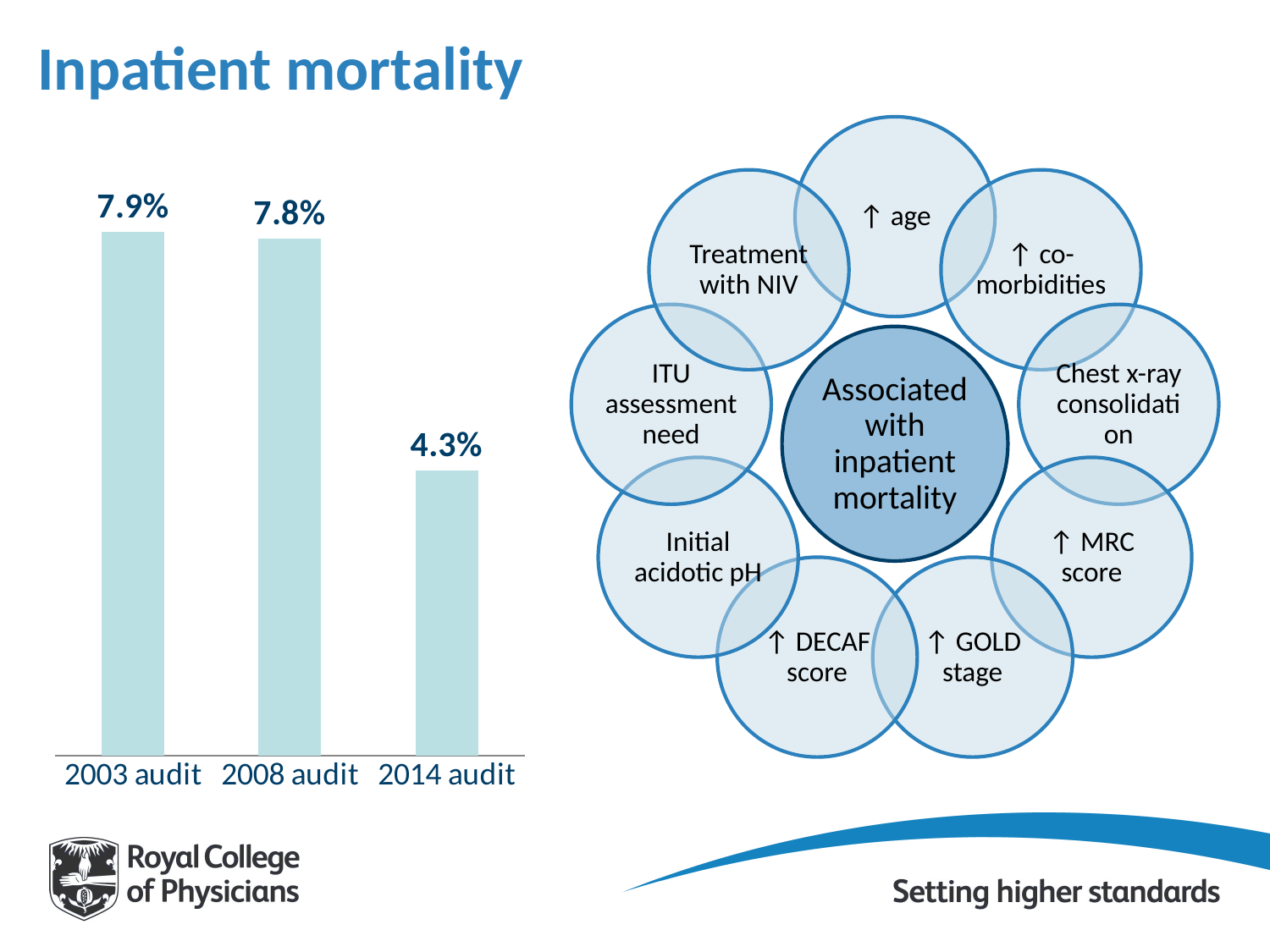
What is the difference in inpatient mortality between the 2008 audit and the 2014 audit? 3.5% Which is larger, the inpatient mortality for the 2008 audit or the 2014 audit? 2008 audit Does inpatient mortality rise or fall from the 2003 audit to the 2014 audit? fall What is the inpatient mortality value for the 2014 audit? 4.3% How many audits are shown in the bar chart? 3 What kind of chart is used to show inpatient mortality? bar chart Which audit has the lowest inpatient mortality? 2014 audit What is the difference in inpatient mortality between the 2003 audit and the 2014 audit? 3.6% What is the title of the slide containing the bar chart? Inpatient mortality What is the inpatient mortality value for the 2008 audit? 7.8% What is the inpatient mortality value for the 2003 audit? 7.9% Which audit has the highest inpatient mortality? 2003 audit